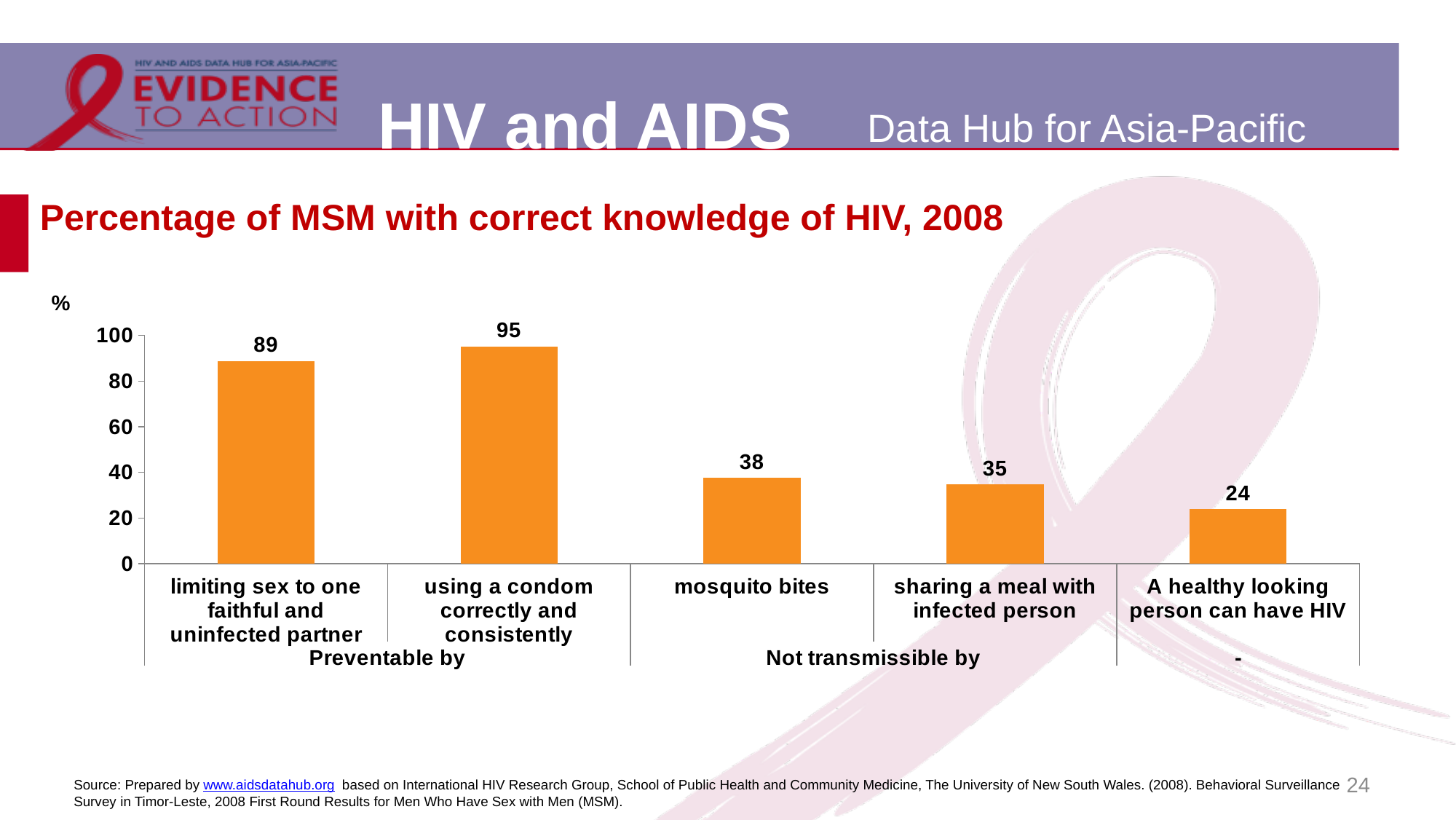
What is the difference between the values for 'using a condom correctly and consistently' and 'limiting sex to one faithful and uninfected partner'? 6 What is the value for 'mosquito bites' in the chart? 38 What is the value for 'A healthy looking person can have HIV'? 24 What is the difference between the values for 'mosquito bites' and 'sharing a meal with infected person'? 3 Which category has the highest value in the chart? using a condom correctly and consistently What is the title of the chart on the slide? Percentage of MSM with correct knowledge of HIV, 2008 Which is larger: the value for 'limiting sex to one faithful and uninfected partner' or the value for 'sharing a meal with infected person'? limiting sex to one faithful and uninfected partner What percentage of MSM had correct knowledge that HIV is preventable by using a condom correctly and consistently? 95 Is the value for 'sharing a meal with infected person' greater or less than 40? less What type of chart is shown on the slide? bar chart Which category has the lowest value in the chart? A healthy looking person can have HIV How many bars are shown in the chart? 5